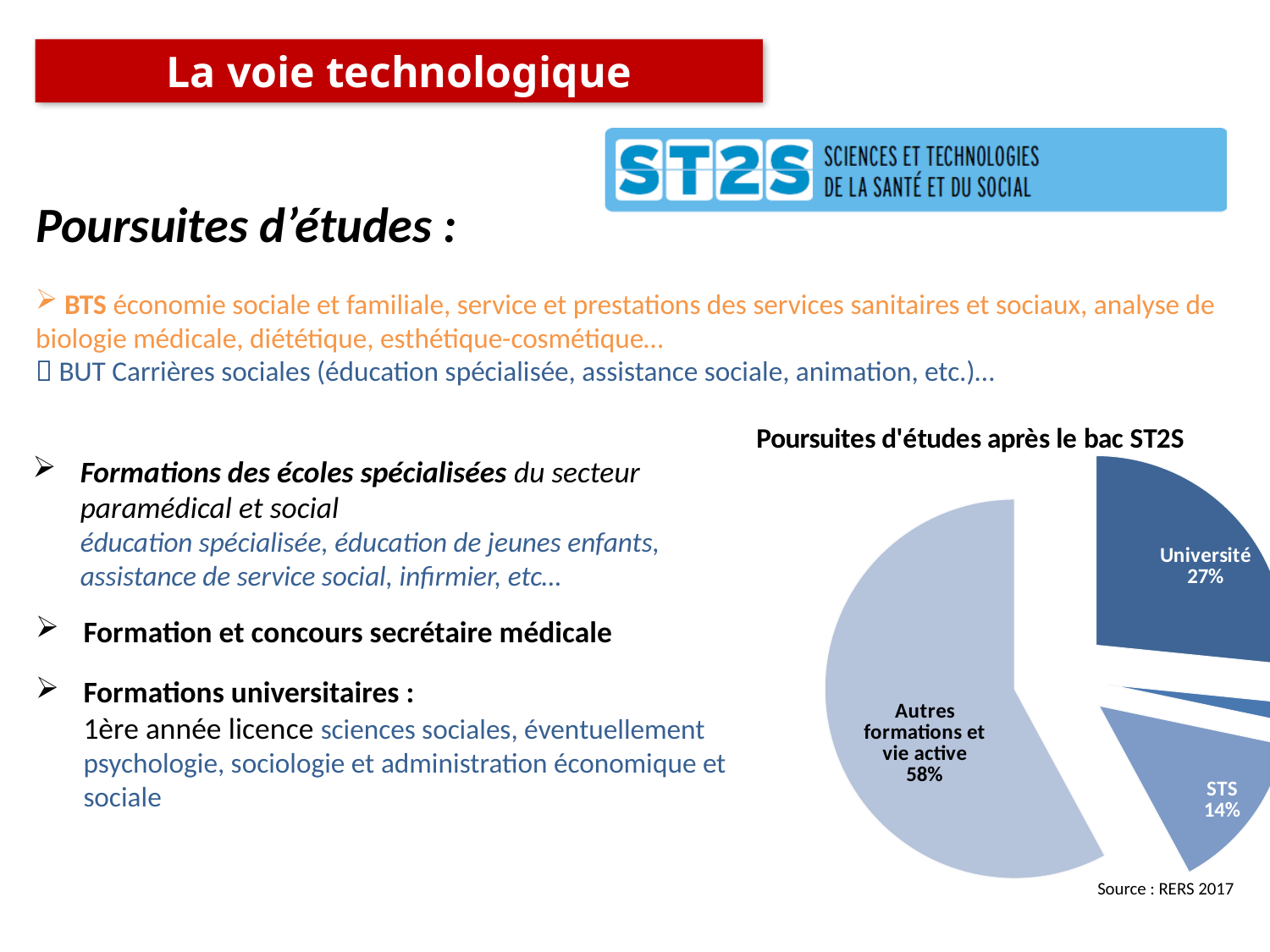
Which is larger, the Université slice or the STS slice? Université What source is cited below the chart? RERS 2017 What share of the pie does Université represent? 27% Is the share for Université greater or less than 50%? less What share of the pie does 'Autres formations et vie active' represent? 58% What is the difference in percentage points between Université and STS? 13 Which labelled slice of the pie is the largest? Autres formations et vie active What is the difference in percentage points between 'Autres formations et vie active' and Université? 31 What type of chart is shown on the slide? pie chart What share of the pie does STS represent? 14% What is the title of the chart? Poursuites d'études après le bac ST2S